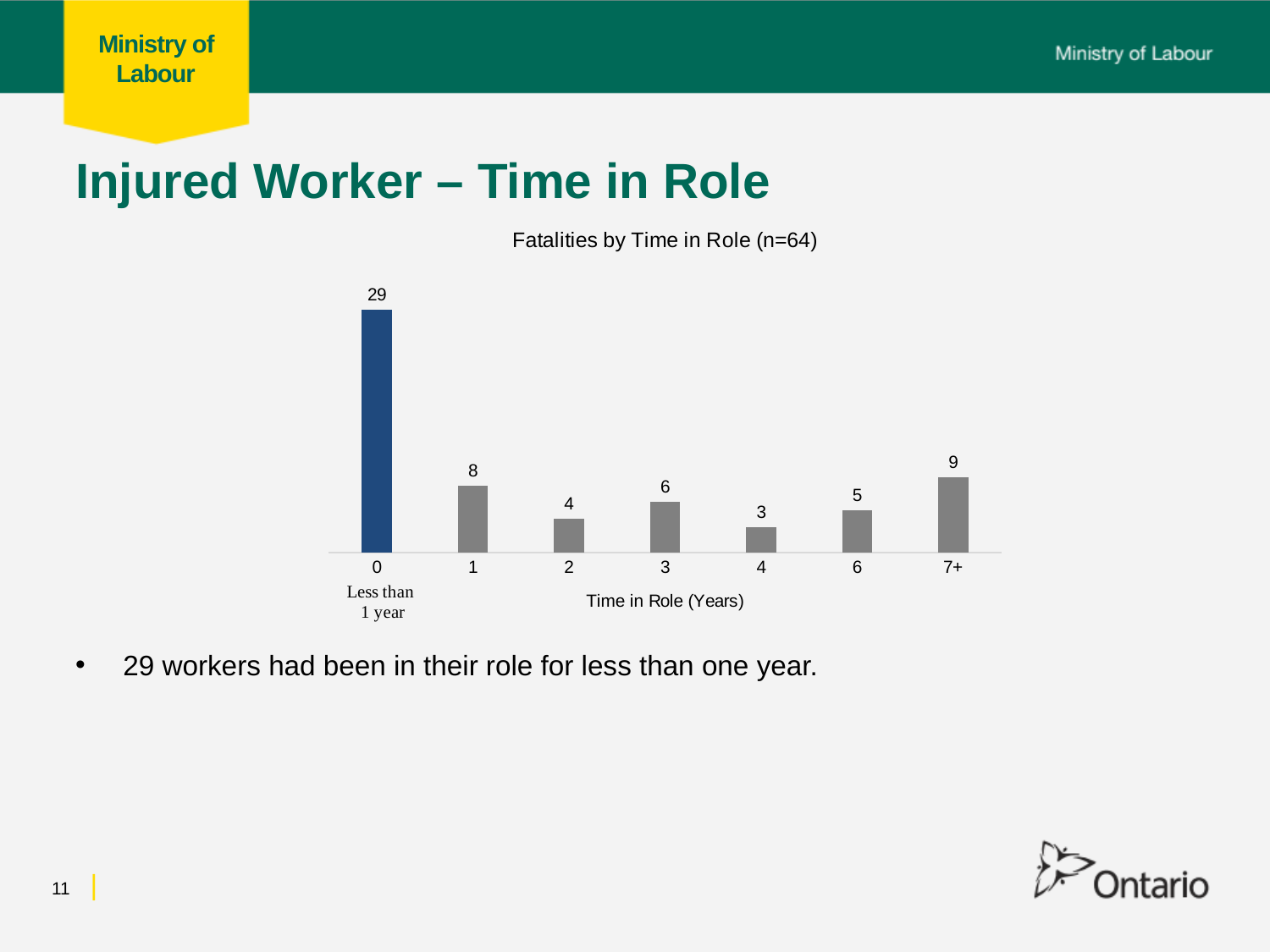
What is the number of fatalities for workers with 4 years in role? 3 What is the x-axis label of the chart? Time in Role (Years) What is the number of fatalities for workers with 0 years (less than 1 year) in role? 29 What is the title of the chart? Fatalities by Time in Role (n=64) Which has more fatalities: 1 year in role or 3 years in role? 1 year What is the difference in fatalities between the 7+ years category and the 6 years category? 4 What is the number of fatalities for workers with 7+ years in role? 9 How many time-in-role categories are shown on the x axis? 7 What type of chart is used to show fatalities by time in role? Bar chart Which time-in-role category has the lowest number of fatalities? 4 Which time-in-role category has the highest number of fatalities? 0 (Less than 1 year) What is the difference in fatalities between the 0 (less than 1 year) category and the 1 year category? 21